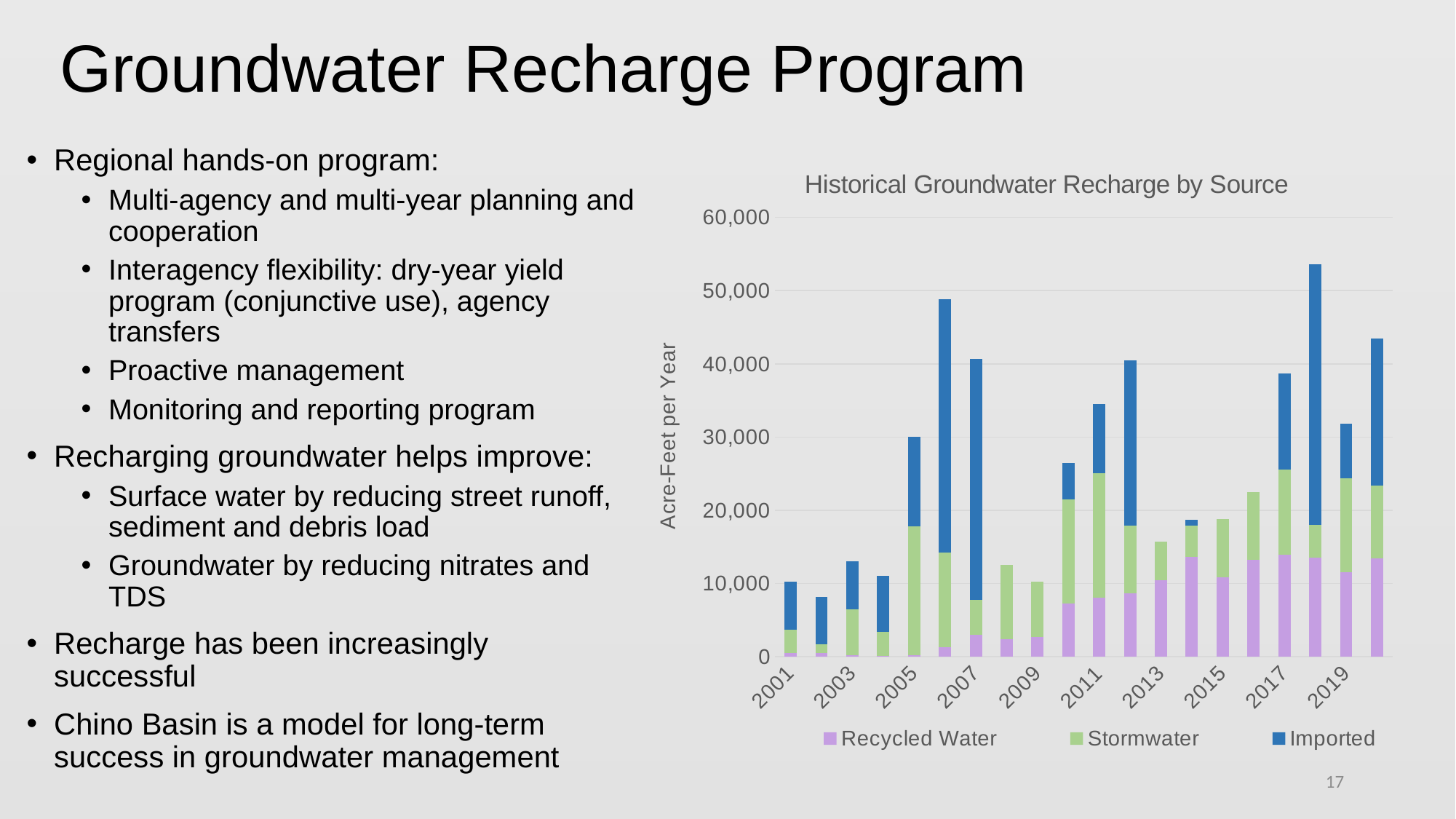
Which year has the shortest total bar in the chart? 2002 Is the total recharge for 2005 greater or less than 20,000 acre-feet? greater Which year has the larger total bar, 2006 or 2007? 2006 Which year has the tallest total bar in the chart? 2018 Is the total recharge for 2018 greater or less than 50,000 acre-feet? greater What kind of chart is shown on the slide? Stacked bar chart What is the label on the vertical axis of the chart? Acre-Feet per Year How many series does the legend of the chart list? 3 Is the total recharge for 2013 greater or less than 20,000 acre-feet? less Which year has the larger total bar, 2011 or 2013? 2011 What is the title of the chart? Historical Groundwater Recharge by Source